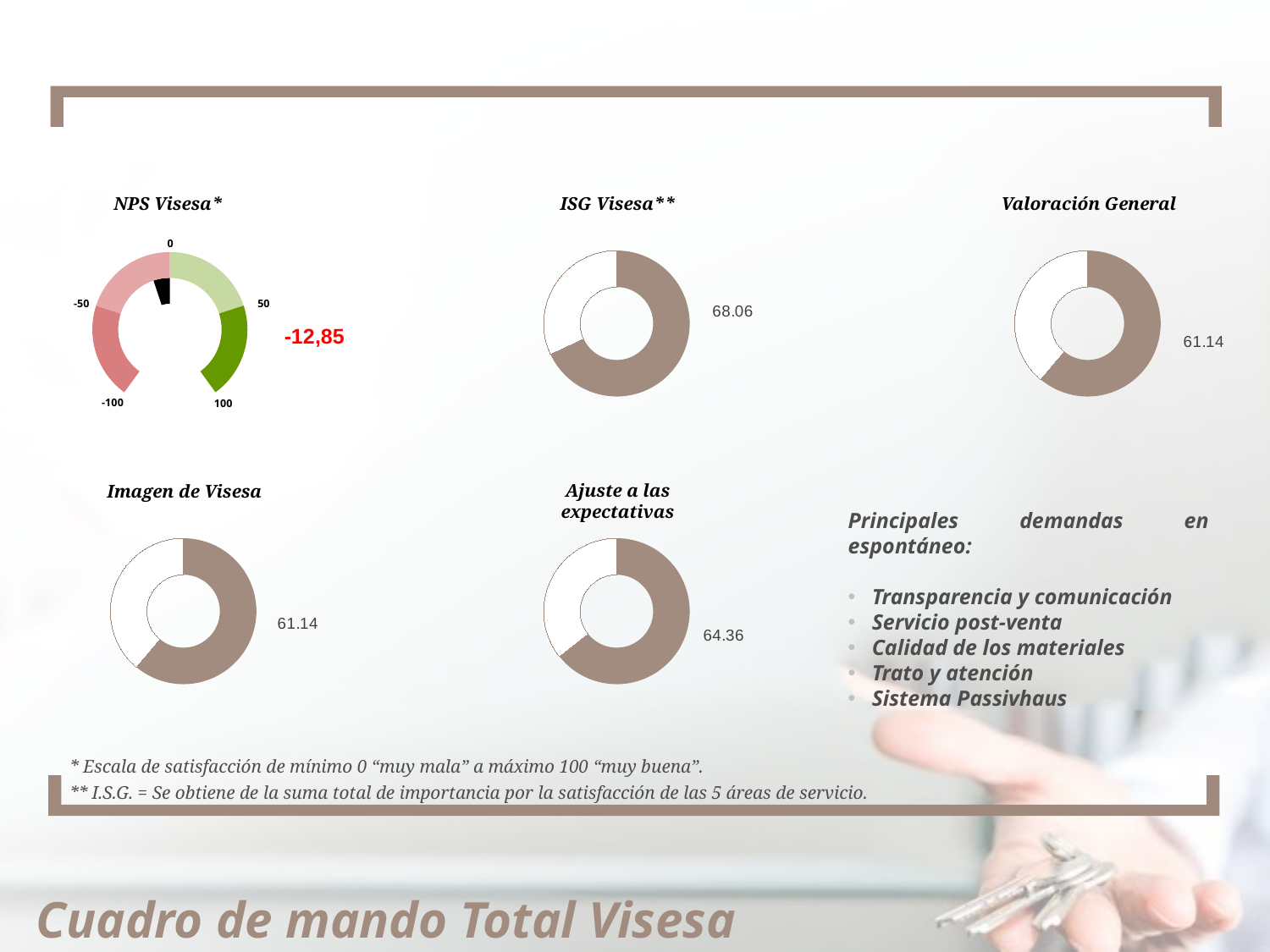
What value is shown on the ISG Visesa** donut chart? 68.06 What kind of chart is the NPS Visesa* chart? Gauge chart What value is shown on the NPS Visesa* gauge chart? -12,85 What value is shown on the Imagen de Visesa donut chart? 61.14 What is the difference between the Ajuste a las expectativas value and the Imagen de Visesa value? 3.22 What are the minimum and maximum values marked on the NPS Visesa* gauge scale? -100 and 100 Which of the four donut charts on the slide shows the highest value? ISG Visesa** What is the difference between the ISG Visesa** value and the Valoración General value? 6.92 Which is larger, the value on the ISG Visesa** chart or the value on the Ajuste a las expectativas chart? ISG Visesa** What kind of chart is the Imagen de Visesa chart? Donut chart What value is shown on the Ajuste a las expectativas donut chart? 64.36 What value is shown on the Valoración General donut chart? 61.14